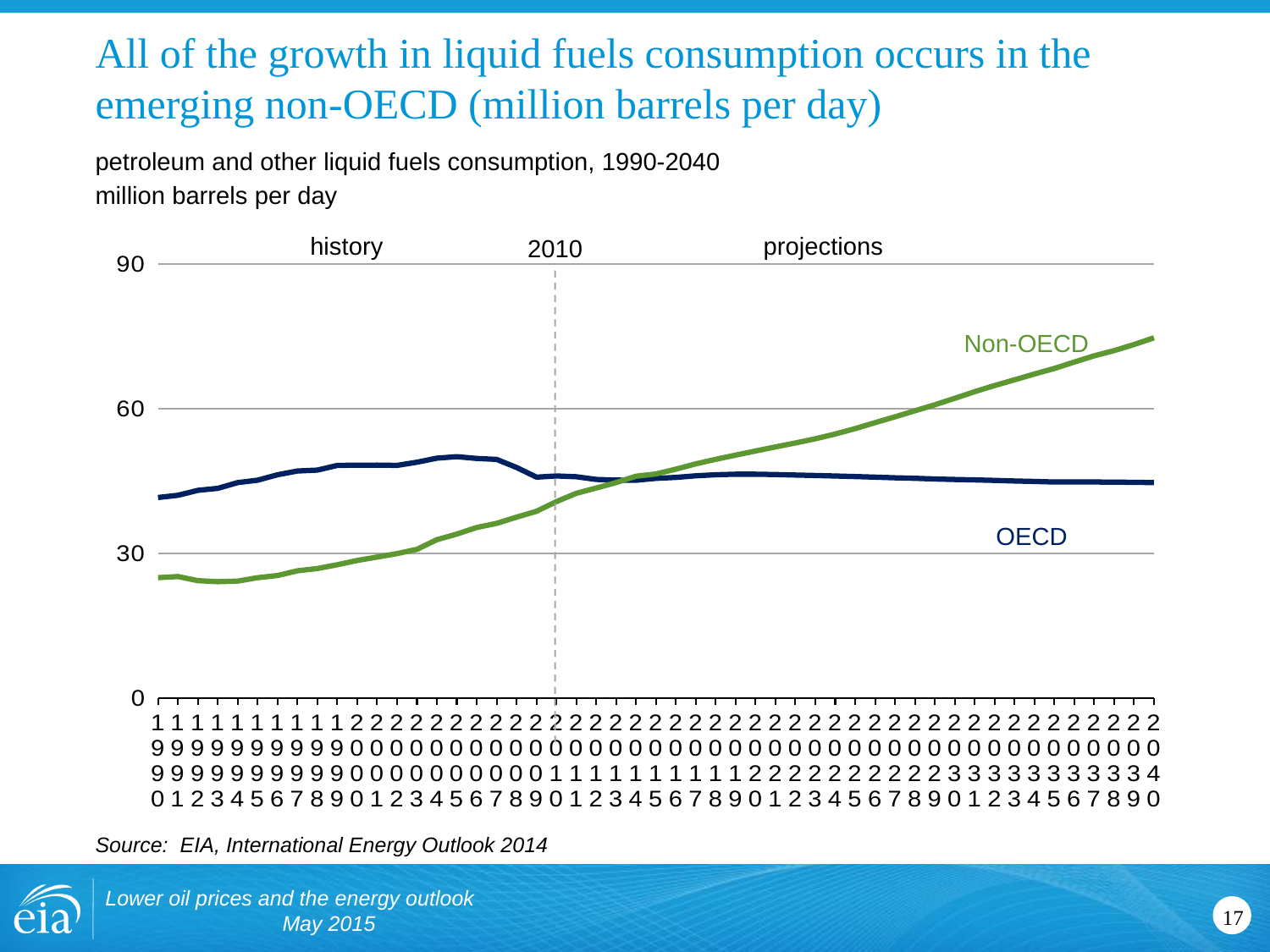
Is the Non-OECD value in 2040 greater or less than 60? greater Is the OECD value in 1990 greater or less than 30? greater Which series is higher in 1990, OECD or Non-OECD? OECD Does the Non-OECD line rise or fall from 2010 to 2040? rise Which series is higher in 2040, OECD or Non-OECD? Non-OECD What year does the dashed vertical line separating history from projections mark? 2010 What unit is the chart's y axis measured in, according to the subtitle? million barrels per day Which series is higher in 2010, OECD or Non-OECD? OECD Is the OECD value in 2040 greater or less than 60? less How many series are plotted on the chart? 2 What kind of chart is shown on the slide? line chart